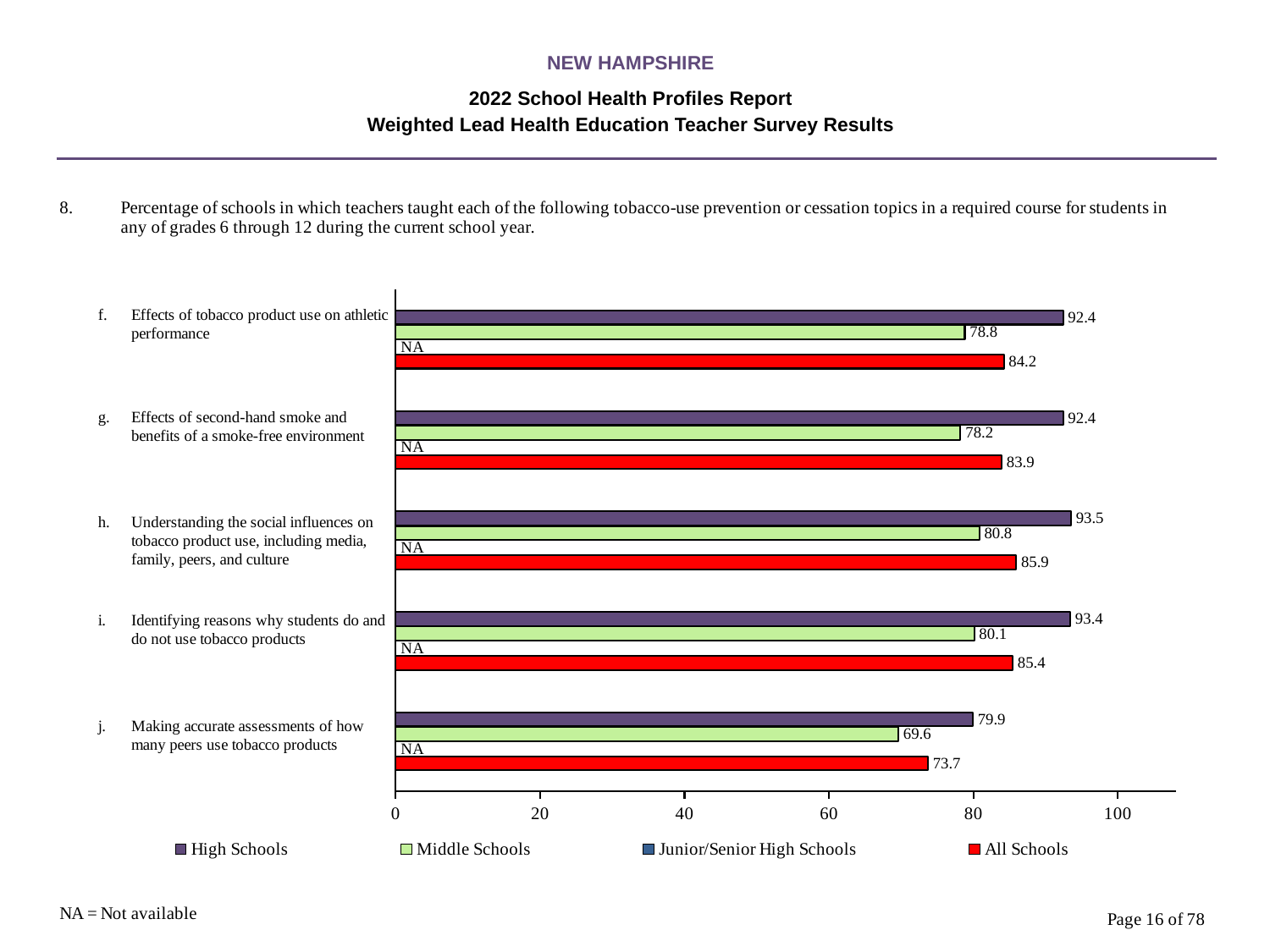
What is the difference between the High Schools and Middle Schools values for 'Effects of tobacco product use on athletic performance'? 13.6 Which is larger: the All Schools value for 'Identifying reasons why students do and do not use tobacco products' or for 'Making accurate assessments of how many peers use tobacco products'? Identifying reasons why students do and do not use tobacco products What is the Middle Schools value for 'Understanding the social influences on tobacco product use, including media, family, peers, and culture'? 80.8 What is the All Schools value for 'Effects of second-hand smoke and benefits of a smoke-free environment'? 83.9 How many series does the legend list? 4 What is the High Schools value for 'Making accurate assessments of how many peers use tobacco products'? 79.9 How many topics (categories) are shown on the chart? 5 Which topic has the highest All Schools value? Understanding the social influences on tobacco product use, including media, family, peers, and culture What kind of chart is shown on the slide? Bar chart Which topic has the lowest Middle Schools value? Making accurate assessments of how many peers use tobacco products What colour are the All Schools bars? Red What is shown for Junior/Senior High Schools for 'Identifying reasons why students do and do not use tobacco products'? NA